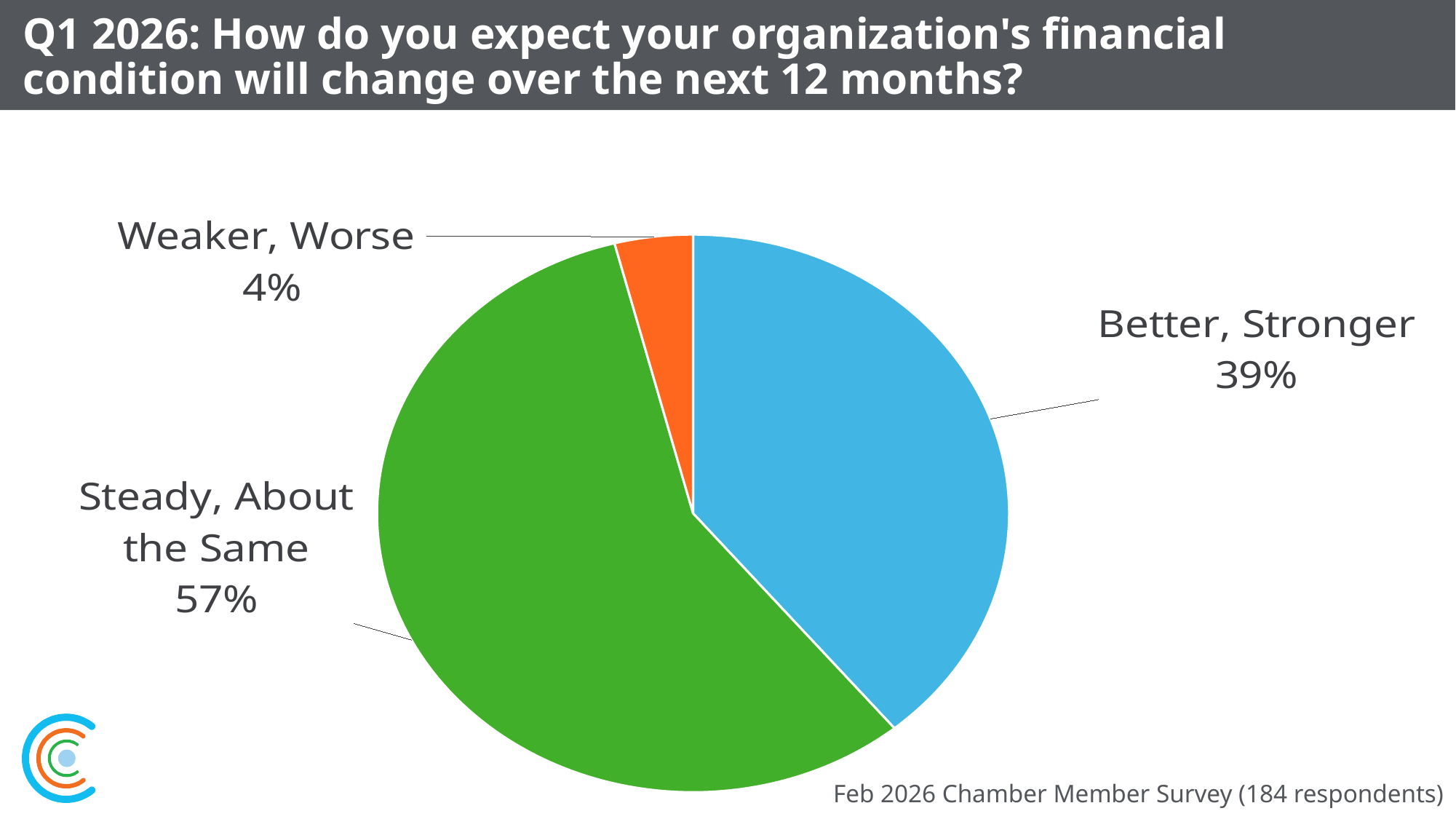
How many respondents does the survey source note say took part? 184 Which response has the largest share of the pie? Steady, About the Same What share of respondents expect their organization's financial condition to be Weaker, Worse? 4% How many response categories are shown in the pie chart? 3 What is the difference in percentage points between the Better, Stronger share and the Weaker, Worse share? 35 What kind of chart is shown on the slide? Pie chart Which response has the smallest share of the pie? Weaker, Worse What colour is the slice for Steady, About the Same? Green What share of respondents expect their organization's financial condition to be Steady, About the Same? 57% What share of respondents expect their organization's financial condition to be Better, Stronger? 39% Which is larger: the share for Better, Stronger or the share for Weaker, Worse? Better, Stronger What is the difference in percentage points between the Steady, About the Same share and the Better, Stronger share? 18